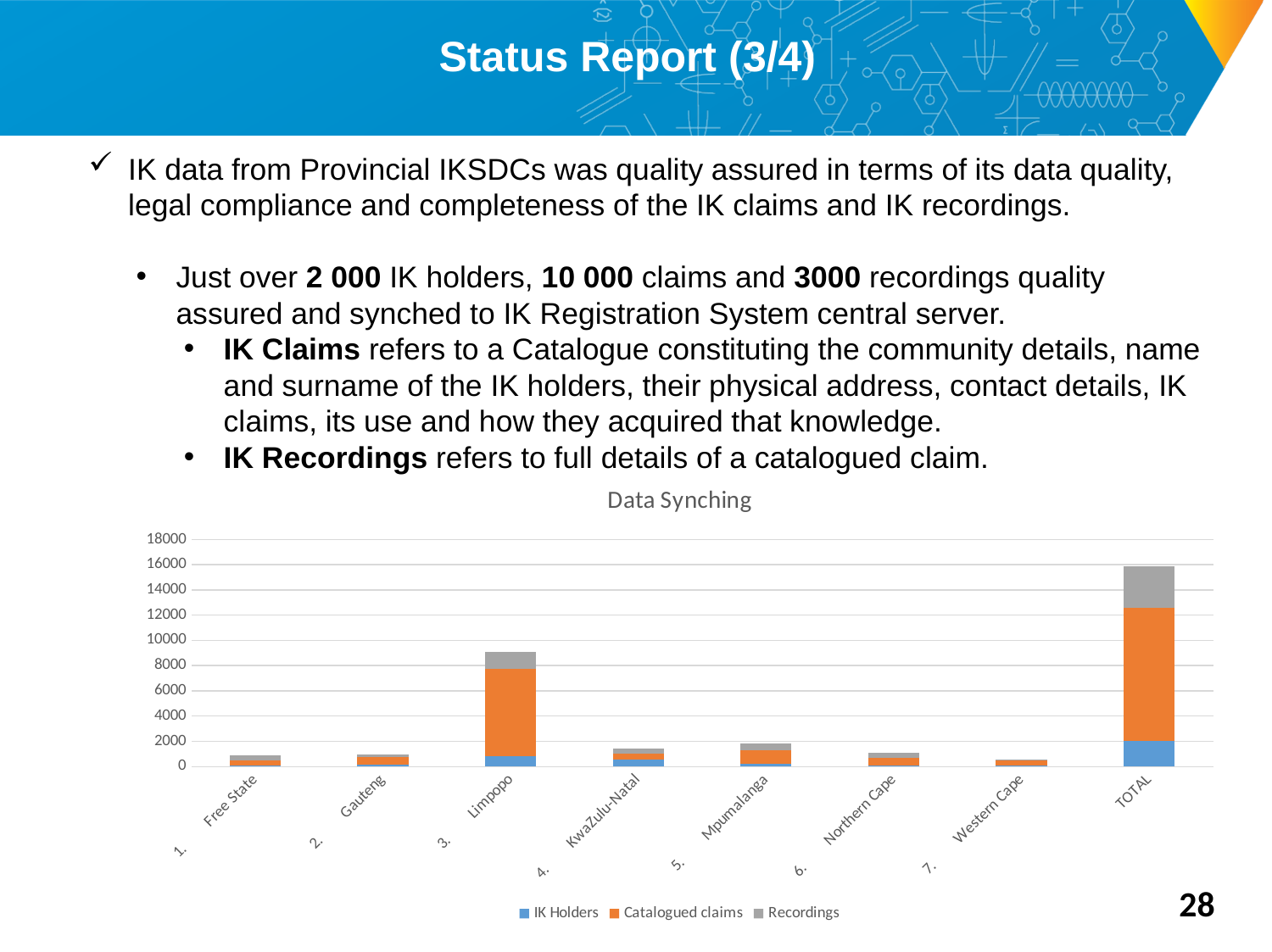
What kind of chart is shown on the slide? Stacked bar chart Which has the taller stacked bar, Limpopo or Gauteng? Limpopo Is the total stacked value for TOTAL greater or less than 14000? greater Is the total stacked value for Limpopo greater or less than 8000? greater Is the total stacked value for Free State greater or less than 2000? less What is the title of the chart? Data Synching Which category has the tallest stacked bar in the chart? TOTAL Which province has the shortest stacked bar in the chart? Western Cape Excluding TOTAL, which province has the tallest stacked bar? Limpopo How many categories are shown on the x axis of the chart? 8 How many series does the chart legend list? 3 Which series are listed in the chart legend? IK Holders, Catalogued claims, Recordings